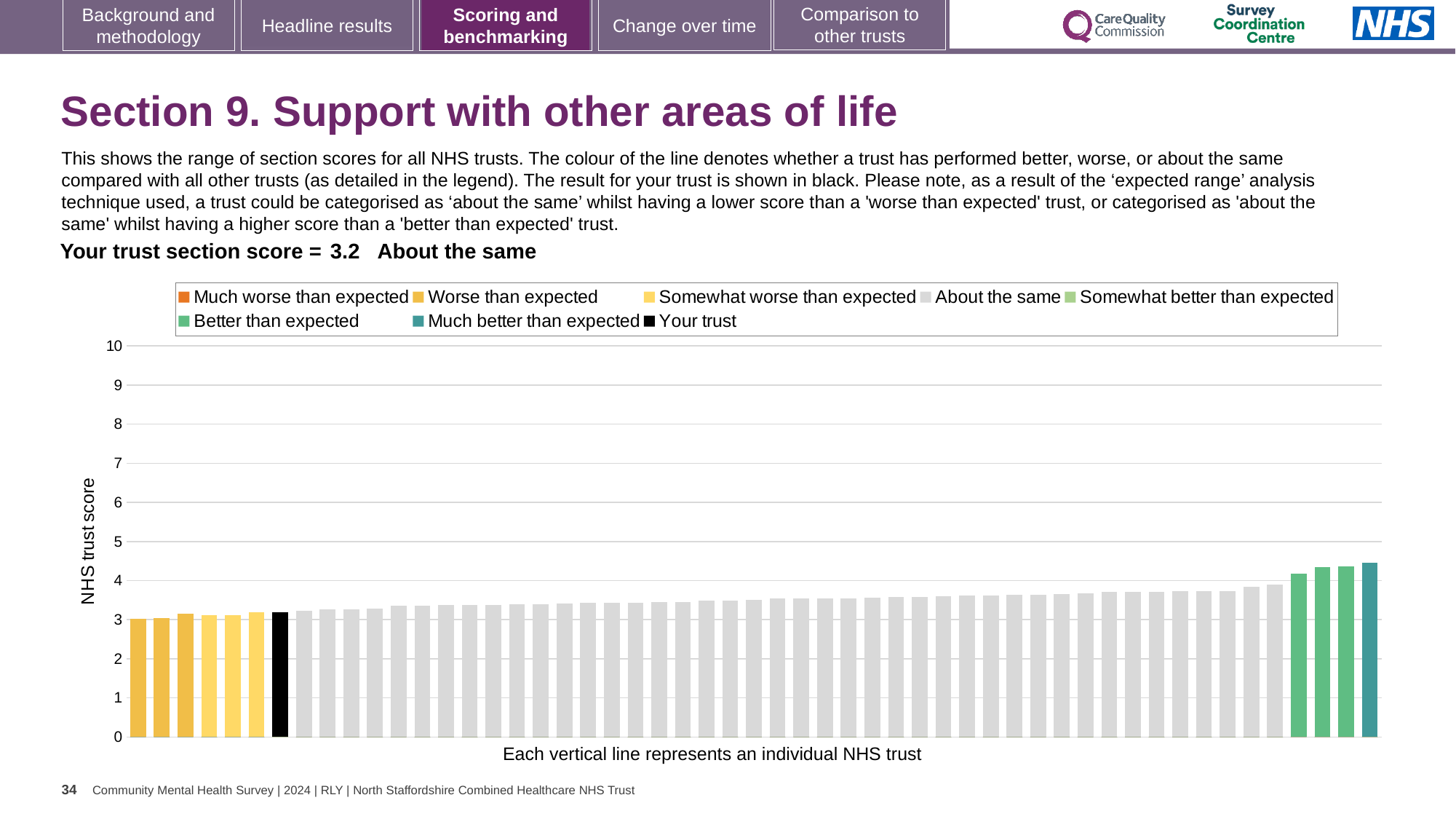
Which is larger: the value for your trust (black bar) or the value for the rightmost bar? the rightmost bar What colour is used for the bar representing your trust? black What is the label on the vertical axis of the chart? NHS trust score Is the value for your trust (the black bar) greater or less than 4? less Which legend category does the tallest bar on the chart belong to? Much better than expected Is the value for the tallest bar on the right of the chart greater or less than 4? greater What is the section score for your trust shown on the slide? 3.2 How many entries does the chart legend list? 8 Which legend category does the shortest bar on the chart belong to? Worse than expected Do the bar values rise or fall moving from left to right along the x axis? rise Is the value for the leftmost bar greater or less than 2? greater What kind of chart is shown on the slide? bar chart